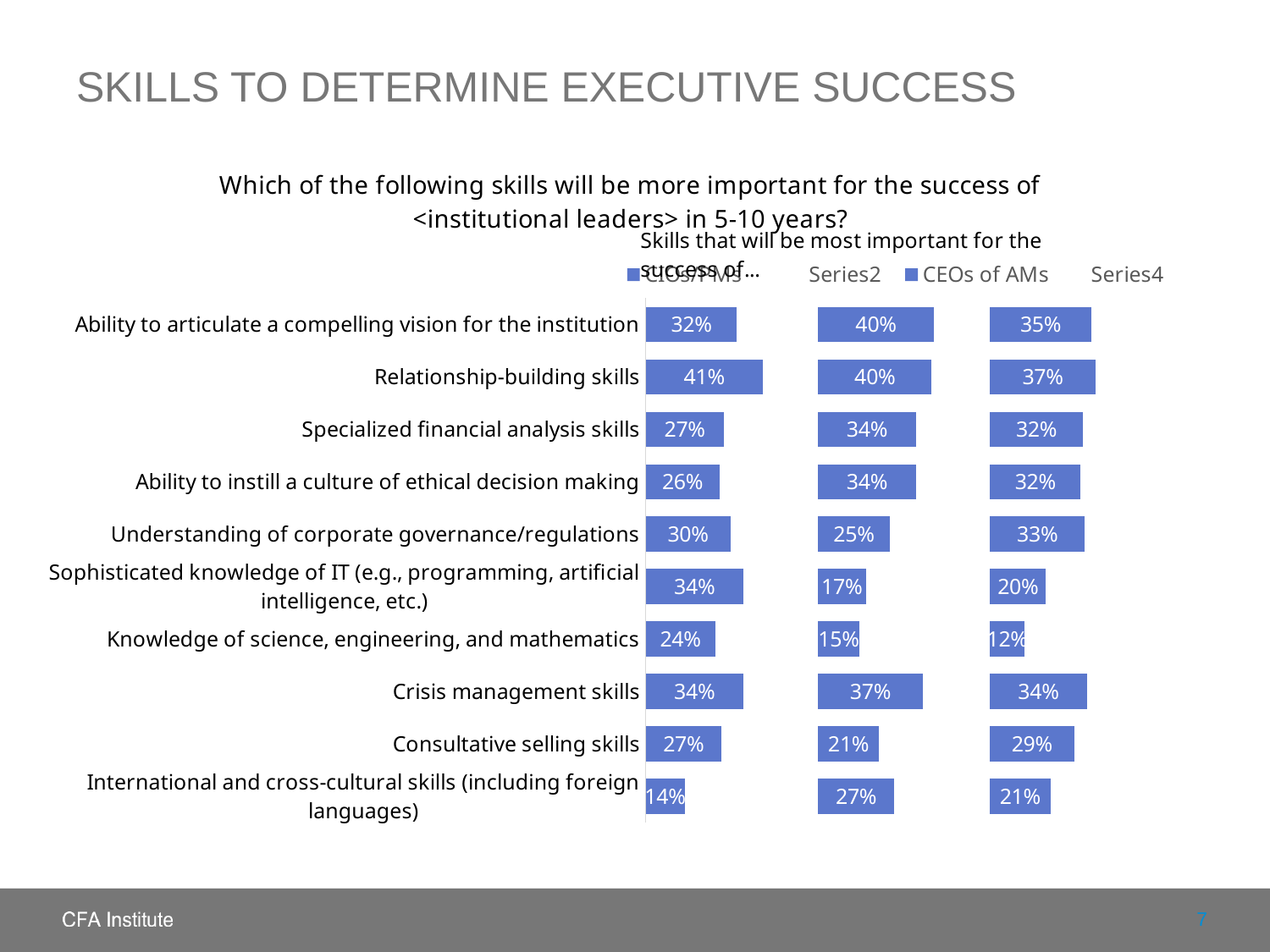
What kind of chart is shown on the slide? Bar chart In the CEOs of AMs series, which is larger: Consultative selling skills or Sophisticated knowledge of IT? Consultative selling skills In the CEOs of AMs series, which skill has the lowest value? Knowledge of science, engineering, and mathematics In the middle set of bars (Series2), what is the value for Crisis management skills? 37% In the CEOs of AMs series, what is the difference between Relationship-building skills and Knowledge of science, engineering, and mathematics? 25 percentage points How many series does the legend list? 4 How many skill categories are listed on the chart? 10 What is the value for Knowledge of science, engineering, and mathematics in the CEOs of AMs series? 15% In the leftmost set of bars, what is the value for Relationship-building skills? 41% What is the value for Relationship-building skills in the CEOs of AMs series? 40% In the CEOs of AMs series, which skill has the highest value? Relationship-building skills and Ability to articulate a compelling vision for the institution (tied at 40%) In the leftmost set of bars, which skill has the highest value? Relationship-building skills